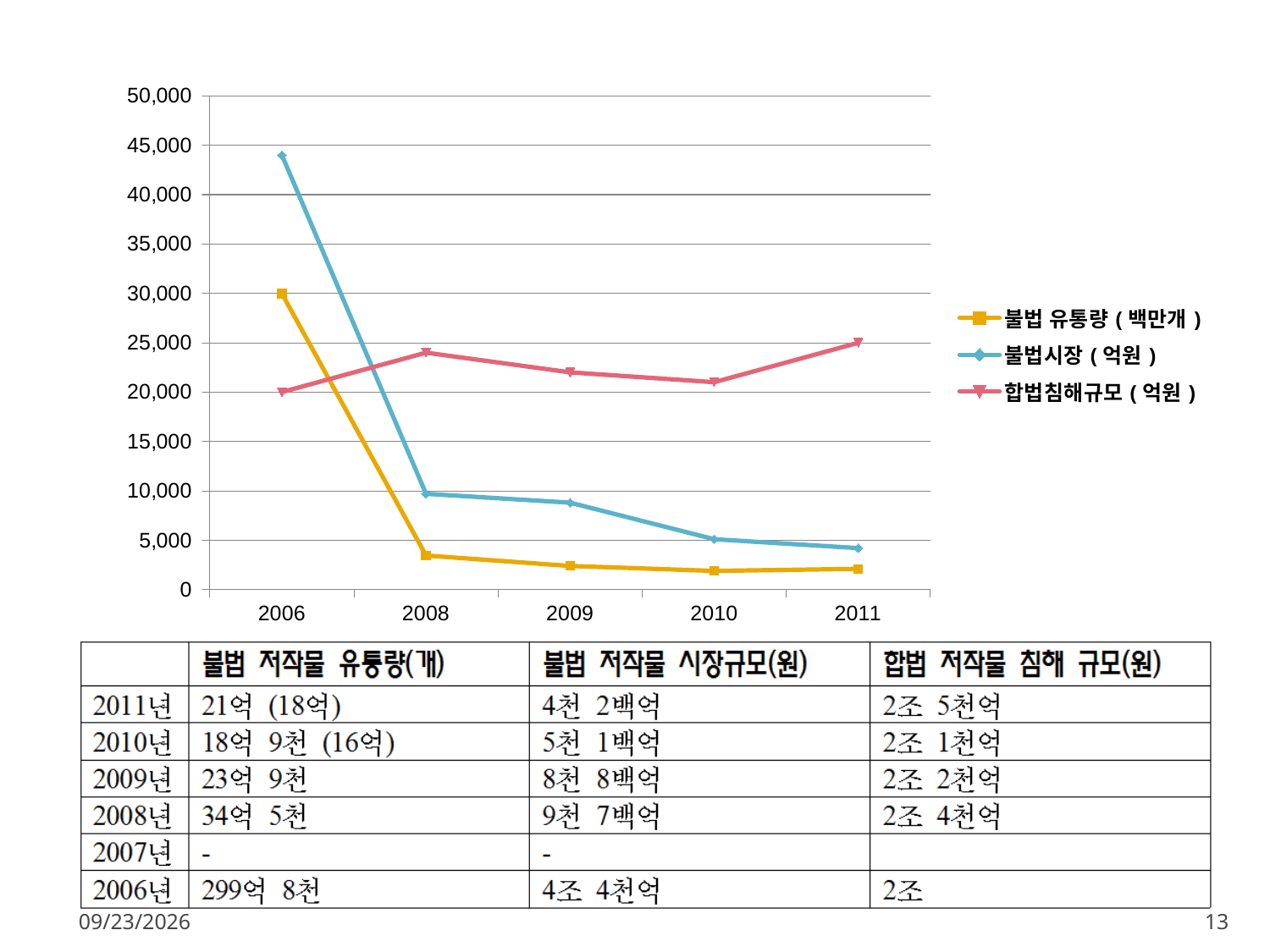
Is the value for 불법 유통량 ( 백만개 ) in 2008 greater or less than 5,000? less In which year is 불법 유통량 ( 백만개 ) highest? 2006 In 2006, which is larger: 불법시장 ( 억원 ) or 불법 유통량 ( 백만개 )? 불법시장 ( 억원 ) How many series does the legend list? 3 Is the value for 불법시장 ( 억원 ) in 2010 greater or less than 10,000? less Does 불법시장 ( 억원 ) rise or fall from 2006 to 2011? fall How many years are plotted along the x axis? 5 Is the value for 합법침해규모 ( 억원 ) in 2008 greater or less than 20,000? greater In 2011, which is larger: 합법침해규모 ( 억원 ) or 불법시장 ( 억원 )? 합법침해규모 ( 억원 ) In which year is 불법시장 ( 억원 ) highest? 2006 What kind of chart is shown on the slide? line chart